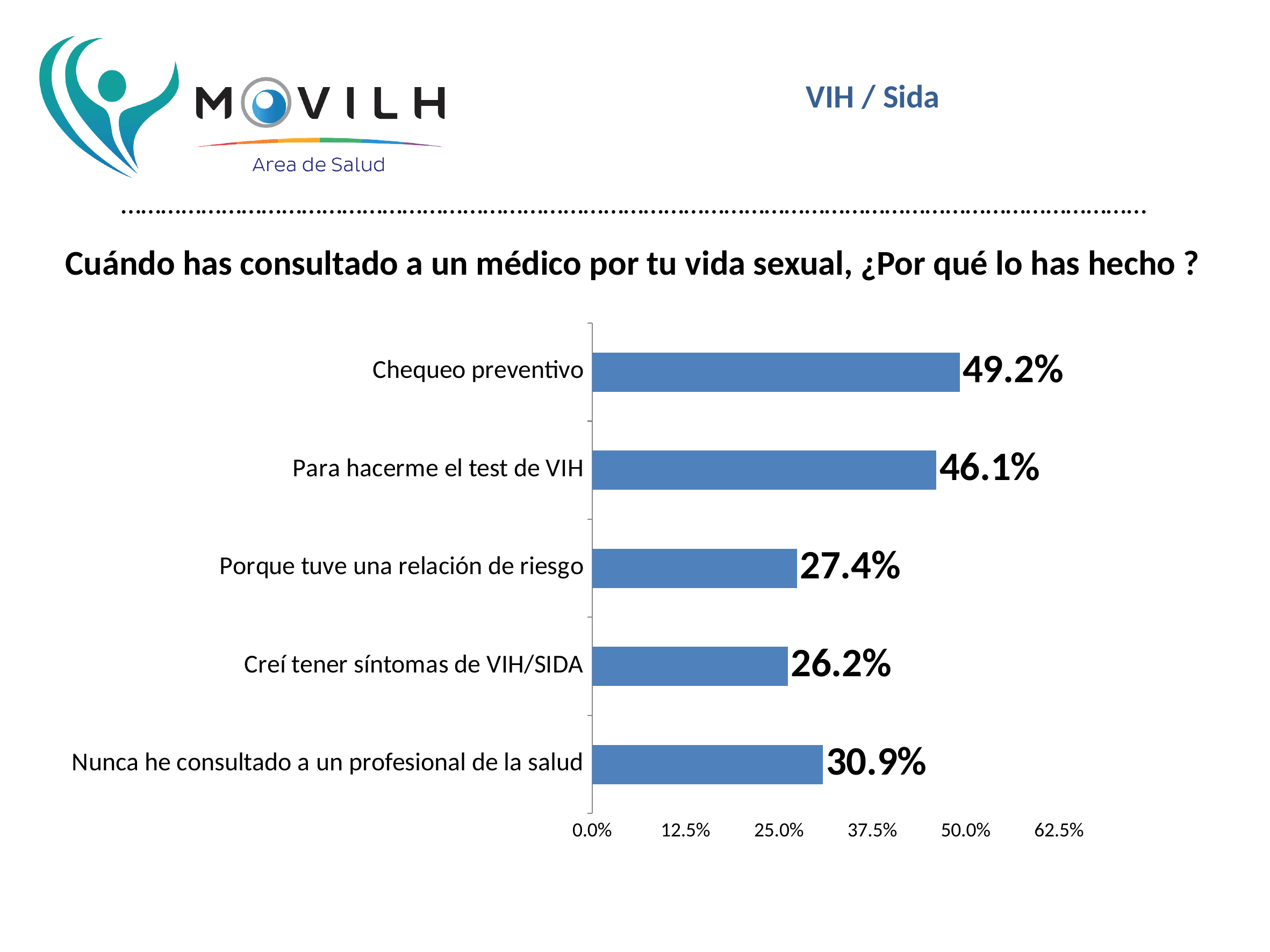
Is the value for "Para hacerme el test de VIH" greater or less than 37.5%? greater Which category has the highest value? Chequeo preventivo How many categories are shown in the chart? 5 What is the value for "Para hacerme el test de VIH"? 46.1% Which is larger, "Porque tuve una relación de riesgo" or "Nunca he consultado a un profesional de la salud"? Nunca he consultado a un profesional de la salud What kind of chart is shown on the slide? Bar chart What is the difference between "Nunca he consultado a un profesional de la salud" and "Porque tuve una relación de riesgo"? 3.5% What is the value for "Creí tener síntomas de VIH/SIDA"? 26.2% What is the value for "Nunca he consultado a un profesional de la salud"? 30.9% Which category has the lowest value? Creí tener síntomas de VIH/SIDA What is the value for "Chequeo preventivo"? 49.2% What is the difference between "Chequeo preventivo" and "Para hacerme el test de VIH"? 3.1%